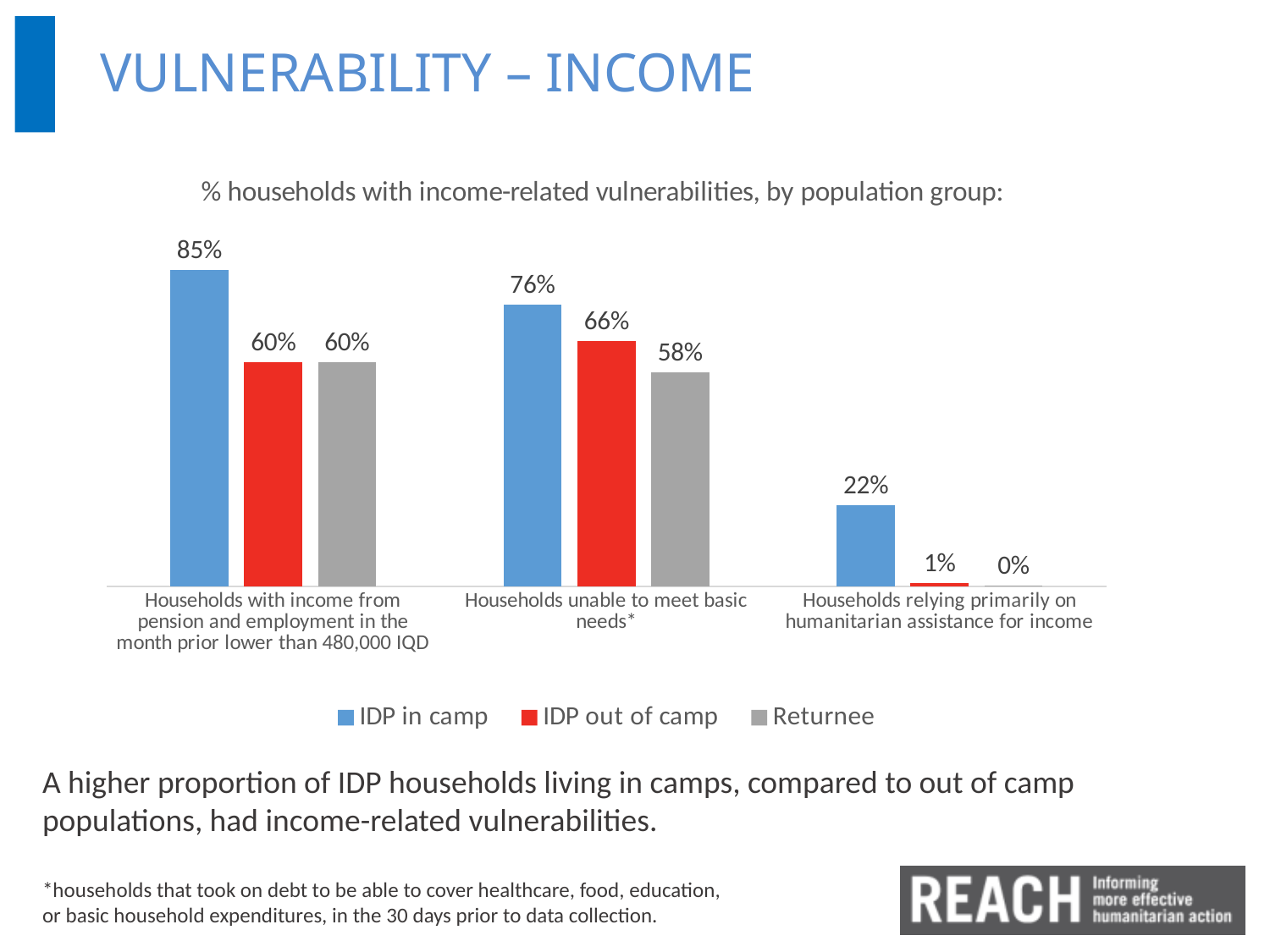
Which population group has the lowest value for households relying primarily on humanitarian assistance for income? Returnee What percentage of IDP in camp households had income from pension and employment in the month prior lower than 480,000 IQD? 85% Which population group has the highest value for households unable to meet basic needs? IDP in camp What is the difference between the IDP in camp and IDP out of camp values for households with income lower than 480,000 IQD? 25% Which colour represents the Returnee series in the chart? Grey Which is larger: the IDP in camp value for households unable to meet basic needs or the IDP in camp value for households relying primarily on humanitarian assistance? Households unable to meet basic needs How many categories are shown on the x axis of the chart? 3 What is the difference between the IDP out of camp and Returnee values for households unable to meet basic needs? 8% What percentage of IDP out of camp households relied primarily on humanitarian assistance for income? 1% What kind of chart is shown on the slide? Bar chart How many series does the legend list? 3 What percentage of Returnee households were unable to meet basic needs? 58%